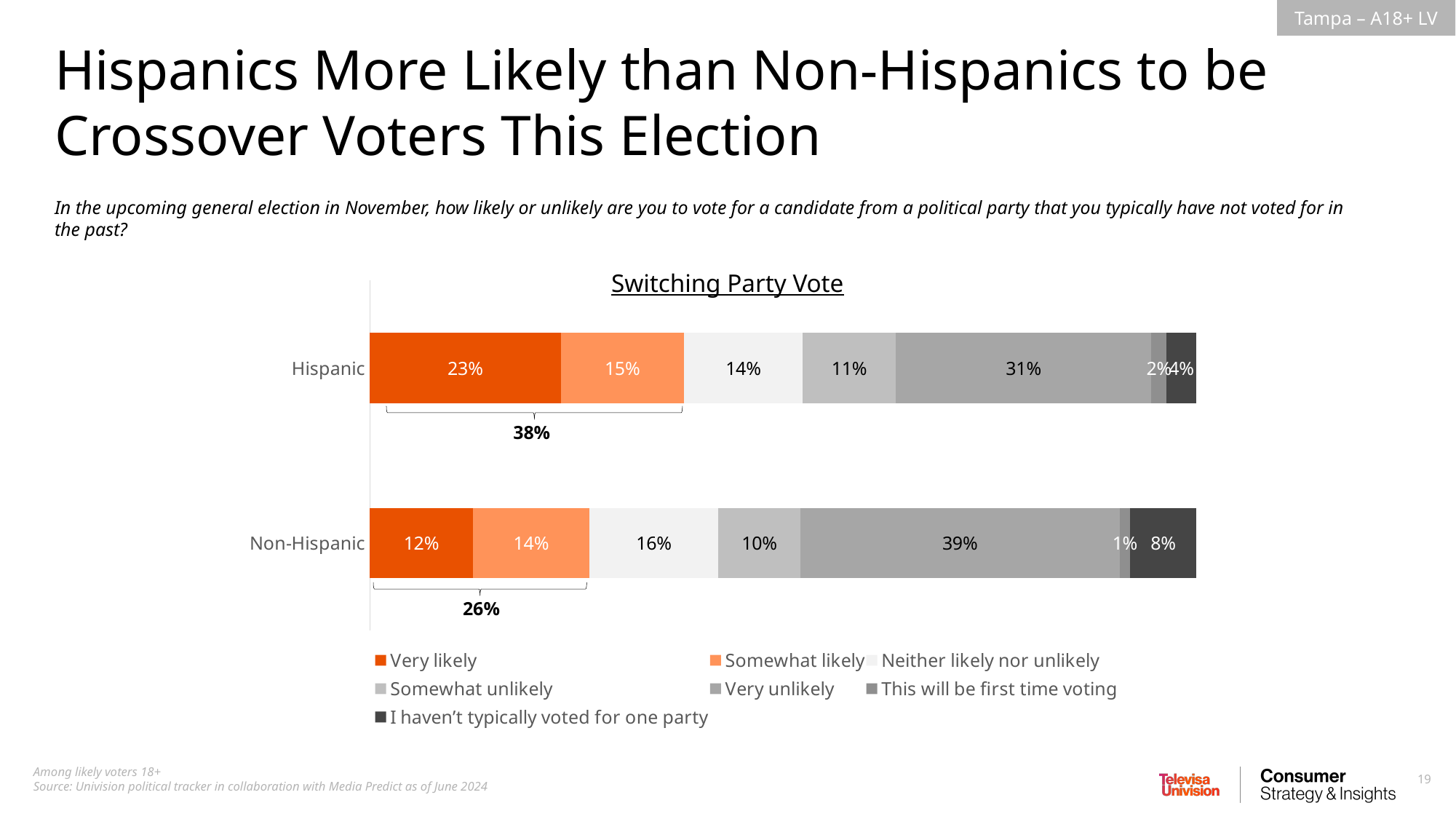
What kind of chart is shown on the slide? Stacked bar chart What is the difference between the "Very likely" values for Hispanic and Non-Hispanic respondents? 11 percentage points Which response category has the lowest value for Non-Hispanic respondents? This will be first time voting What is the title of the chart? Switching Party Vote What is the combined "Very likely" plus "Somewhat likely" share shown for Non-Hispanic respondents? 26% Which group has the larger "Neither likely nor unlikely" share, Hispanic or Non-Hispanic? Non-Hispanic What percentage of Non-Hispanic respondents said "I haven't typically voted for one party"? 8% What percentage of Non-Hispanic respondents are "Very unlikely" to switch their party vote? 39% How many series does the legend list? 7 What percentage of Hispanic respondents are "Very likely" to switch their party vote? 23% Which response category has the highest value for Hispanic respondents? Very unlikely What is the combined "Very likely" plus "Somewhat likely" share shown for Hispanic respondents? 38%